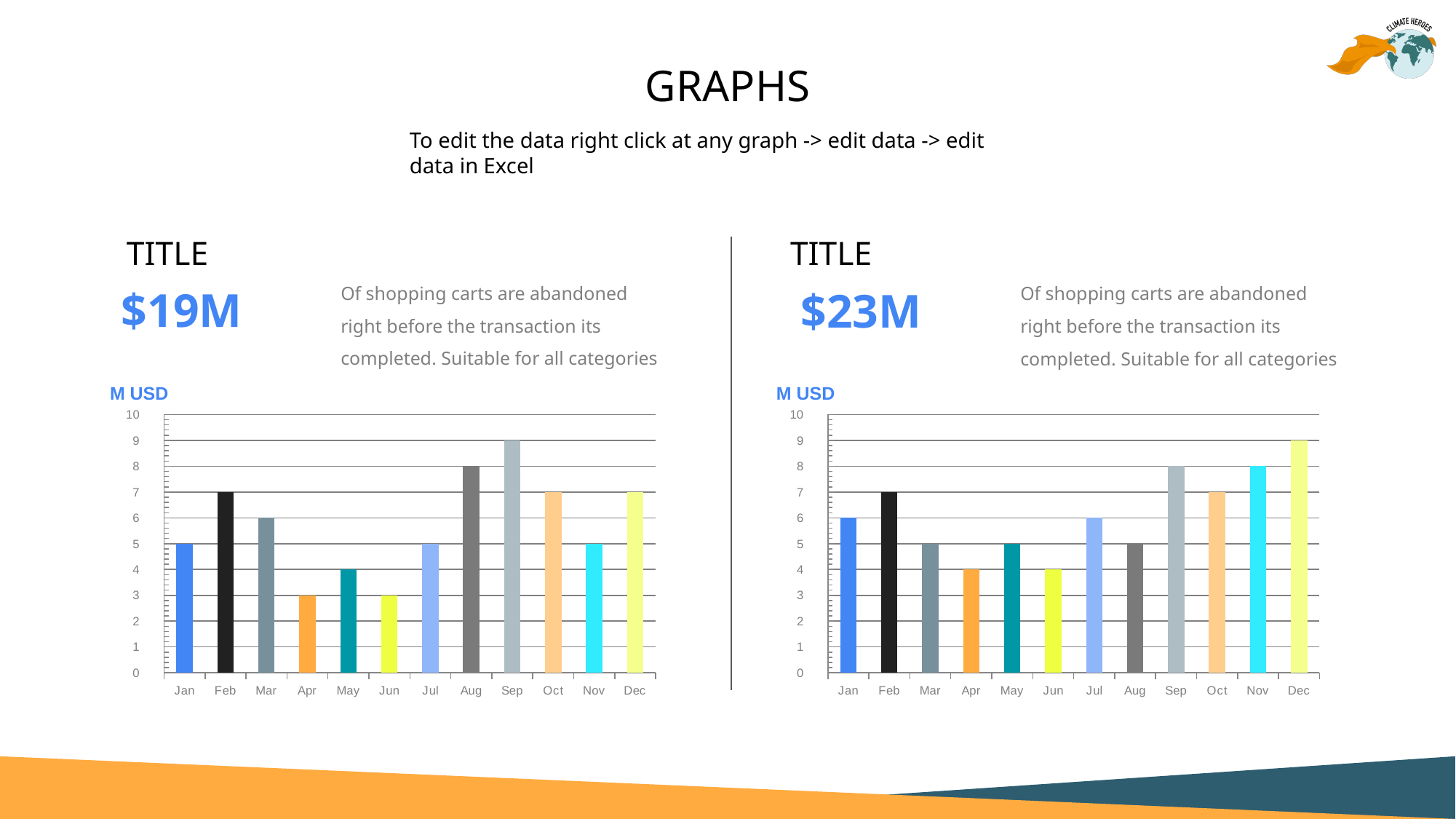
In the left chart, what is the value for Aug? 8 In the left chart, which month has the highest value? Sep How many months are shown on the x axis of the right chart? 12 In the left chart, is the value for Feb greater or less than 5? greater In the right chart, which month has the highest value? Dec What unit label is shown above the left chart? M USD In the left chart, what is the value for Sep? 9 In the right chart, what is the value for Nov? 8 In the right chart, which is larger, the value for Feb or the value for Mar? Feb In the right chart, what is the value for Jan? 6 In the left chart, what is the difference between the values for Sep and Apr? 6 What type of chart is the left chart on the slide? bar chart